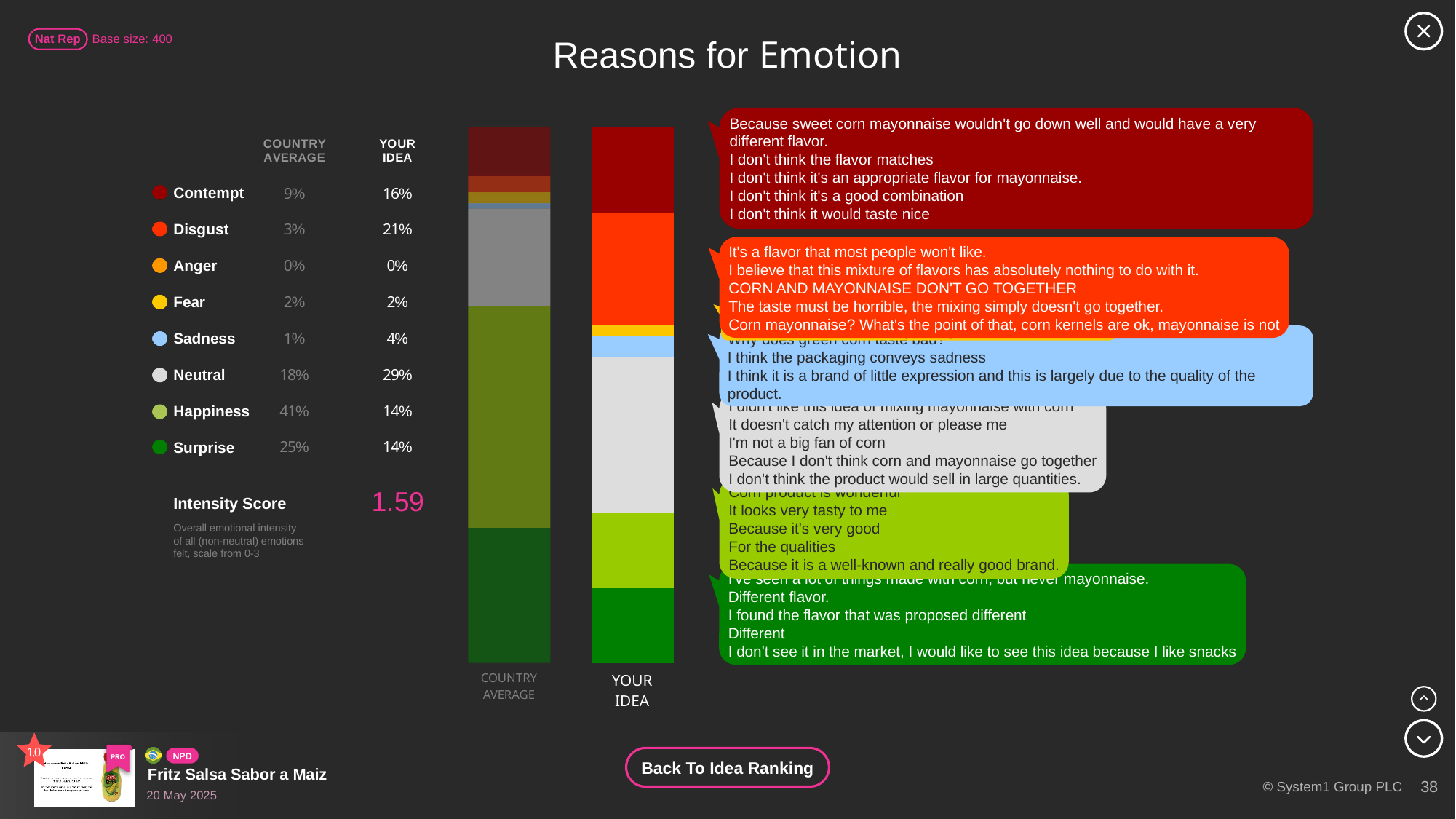
What is the Intensity Score shown on the slide? 1.59 How much higher is the Contempt value for Your Idea than for the Country Average? 7 percentage points Which emotion has the highest value for Your Idea? Neutral What is the Disgust value for Your Idea? 21% Which emotion has the highest value for the Country Average? Happiness Which emotion has the lowest value for Your Idea? Anger What is the Happiness value for the Country Average? 41% How many stacked bars are shown in the chart? 2 What kind of chart is shown on the slide? Stacked bar chart What is the difference between the Disgust values for Your Idea and the Country Average? 18 percentage points How many emotion categories are shown in the chart? 8 Is the Happiness value larger for the Country Average or for Your Idea? Country Average